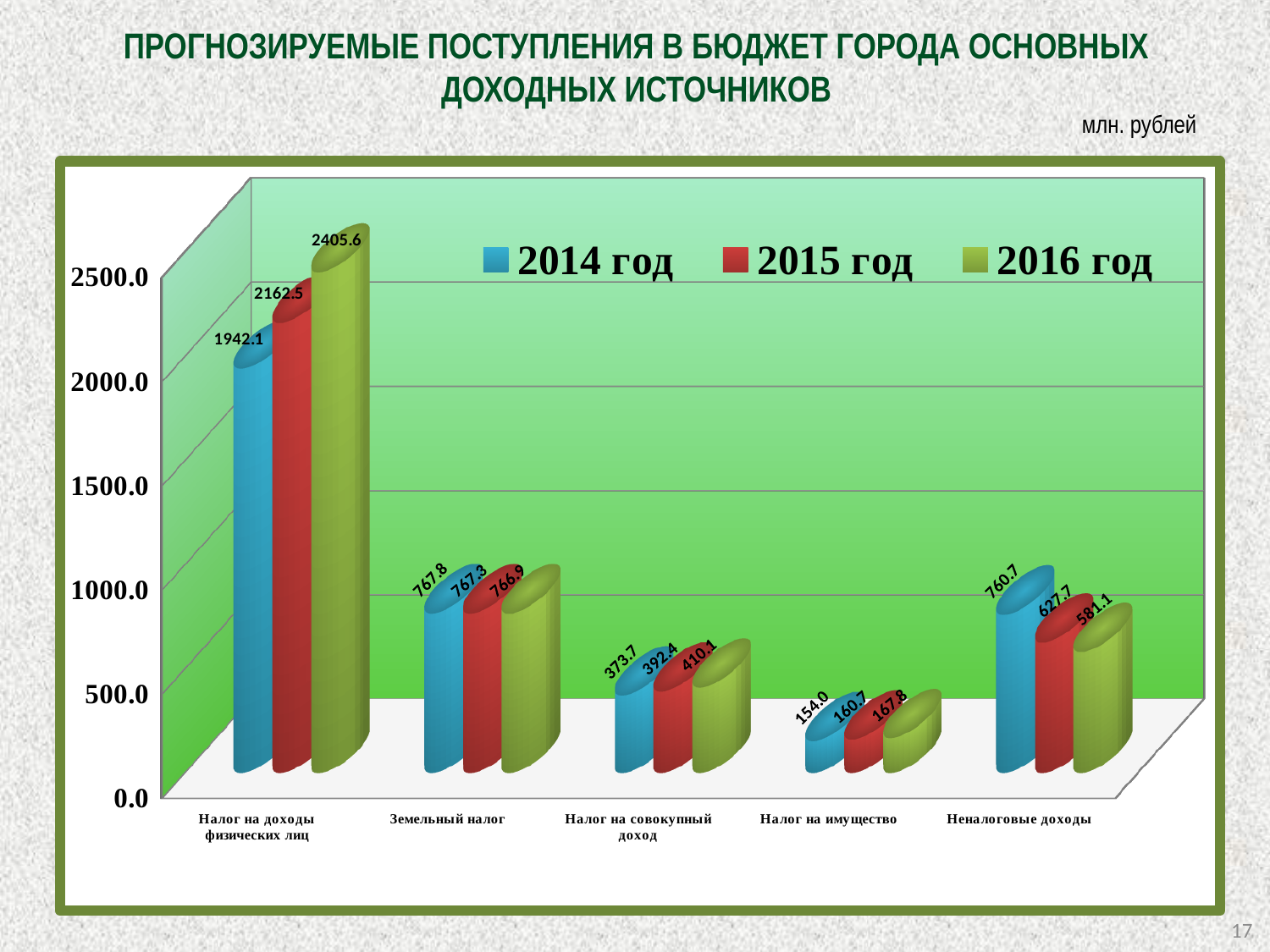
Do the values for Налог на совокупный доход rise or fall from 2014 год to 2016 год? Rise How many series does the legend list? 3 What is the difference between the 2016 год and 2014 год values for Налог на доходы физических лиц? 463.5 What is the value for Неналоговые доходы in the 2014 год series? 760.7 What is the value for Налог на доходы физических лиц in the 2016 год series? 2405.6 Which is larger for Неналоговые доходы: the 2014 год value or the 2016 год value? 2014 год What unit is stated above the chart? млн. рублей How many categories are shown on the x axis? 5 Which category has the highest value in the 2015 год series? Налог на доходы физических лиц What is the value for Налог на имущество in the 2015 год series? 160.7 What kind of chart is shown on the slide? Bar chart Which category has the lowest value in the 2016 год series? Налог на имущество